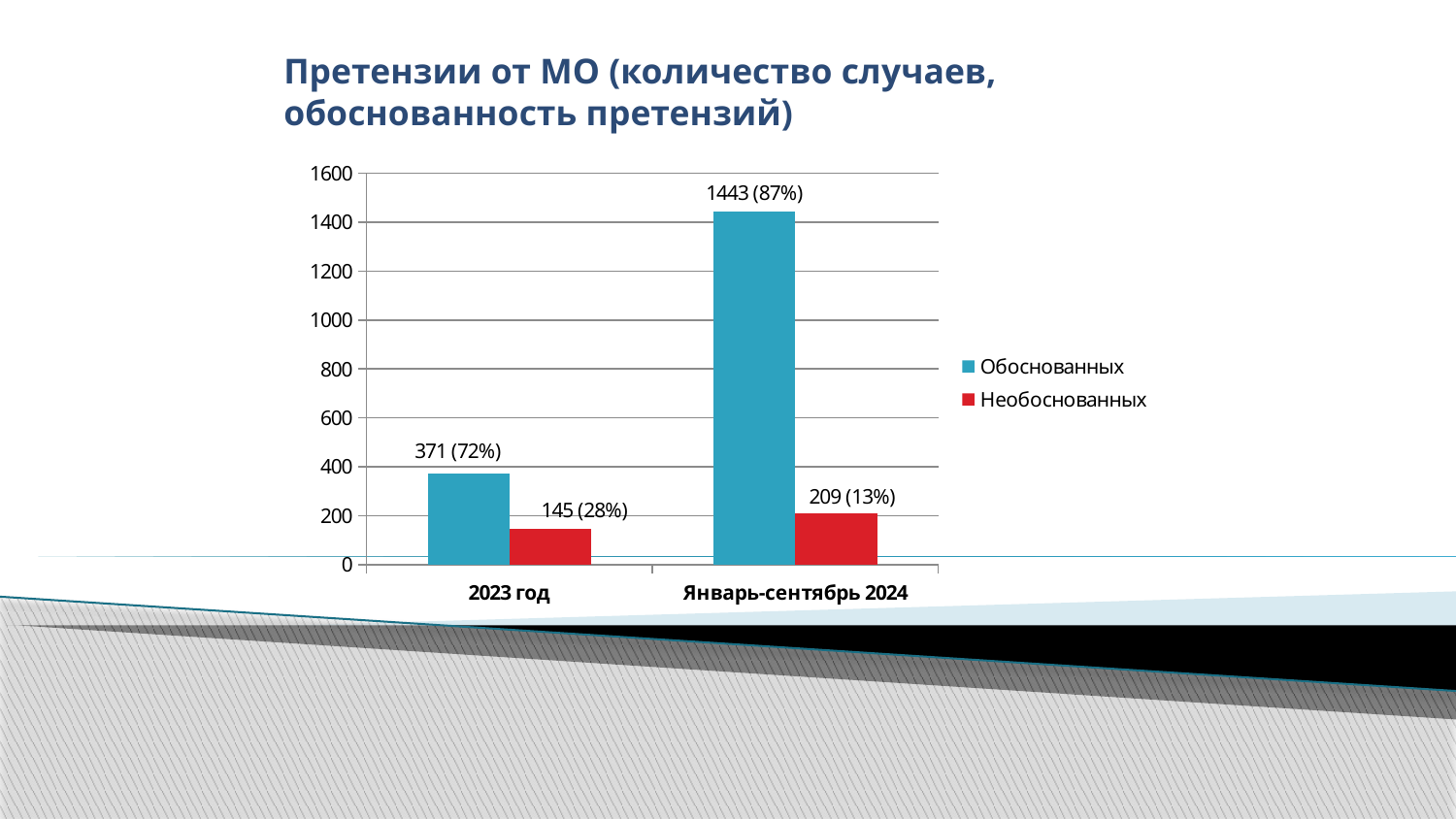
How many series does the legend list? 2 What is the value of the Необоснованных bar for 2023 год? 145 (28%) What is the value of the Необоснованных bar for Январь-сентябрь 2024? 209 (13%) What kind of chart is shown on the slide? Bar chart What is the value of the Обоснованных bar for Январь-сентябрь 2024? 1443 (87%) Which category has the lowest Необоснованных value? 2023 год What is the difference in the number of Обоснованных cases between Январь-сентябрь 2024 and 2023 год? 1072 Which is larger: the Необоснованных value for 2023 год or for Январь-сентябрь 2024? Январь-сентябрь 2024 Which colour represents the Необоснованных series? Red What is the value of the Обоснованных bar for 2023 год? 371 (72%) Which category has the highest Обоснованных value? Январь-сентябрь 2024 How many categories are shown on the x axis? 2